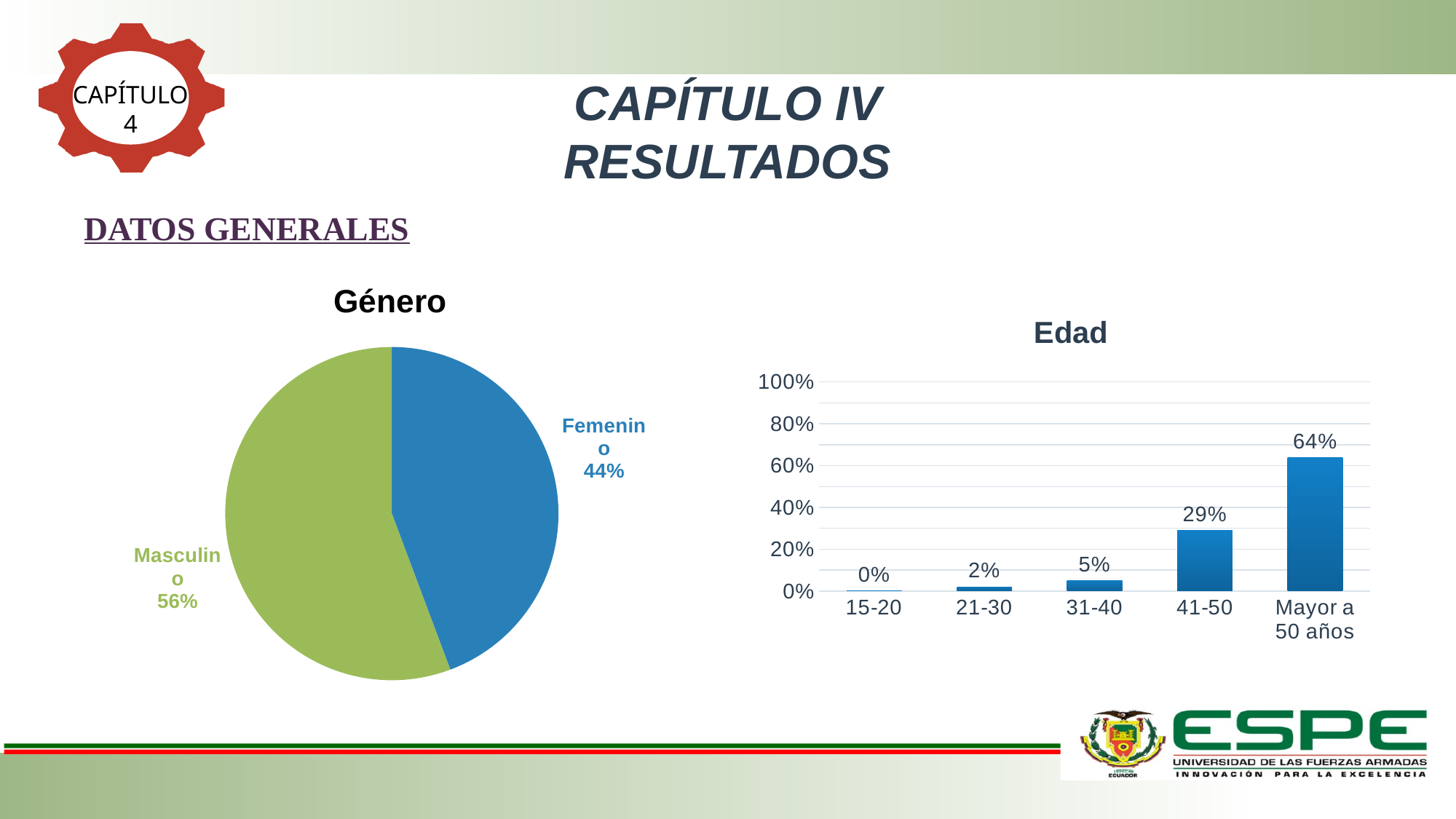
In the 'Edad' chart, how many age categories are shown? 5 In the 'Género' chart, which category has the larger share? Masculino In the 'Edad' chart, what is the difference between Mayor a 50 años and 41-50? 35% In the 'Edad' chart, which category has the lowest value? 15-20 What kind of chart is the 'Género' chart? Pie chart In the 'Edad' chart, do the values rise or fall from 15-20 to Mayor a 50 años? Rise In the 'Edad' chart, what is the value for 41-50? 29% In the 'Género' chart, how many slices are there? 2 In the 'Género' chart, what share is Masculino? 56% In the 'Edad' chart, which category has the highest value? Mayor a 50 años In the 'Edad' chart, what is the value for Mayor a 50 años? 64% In the 'Género' chart, what share is Femenino? 44%